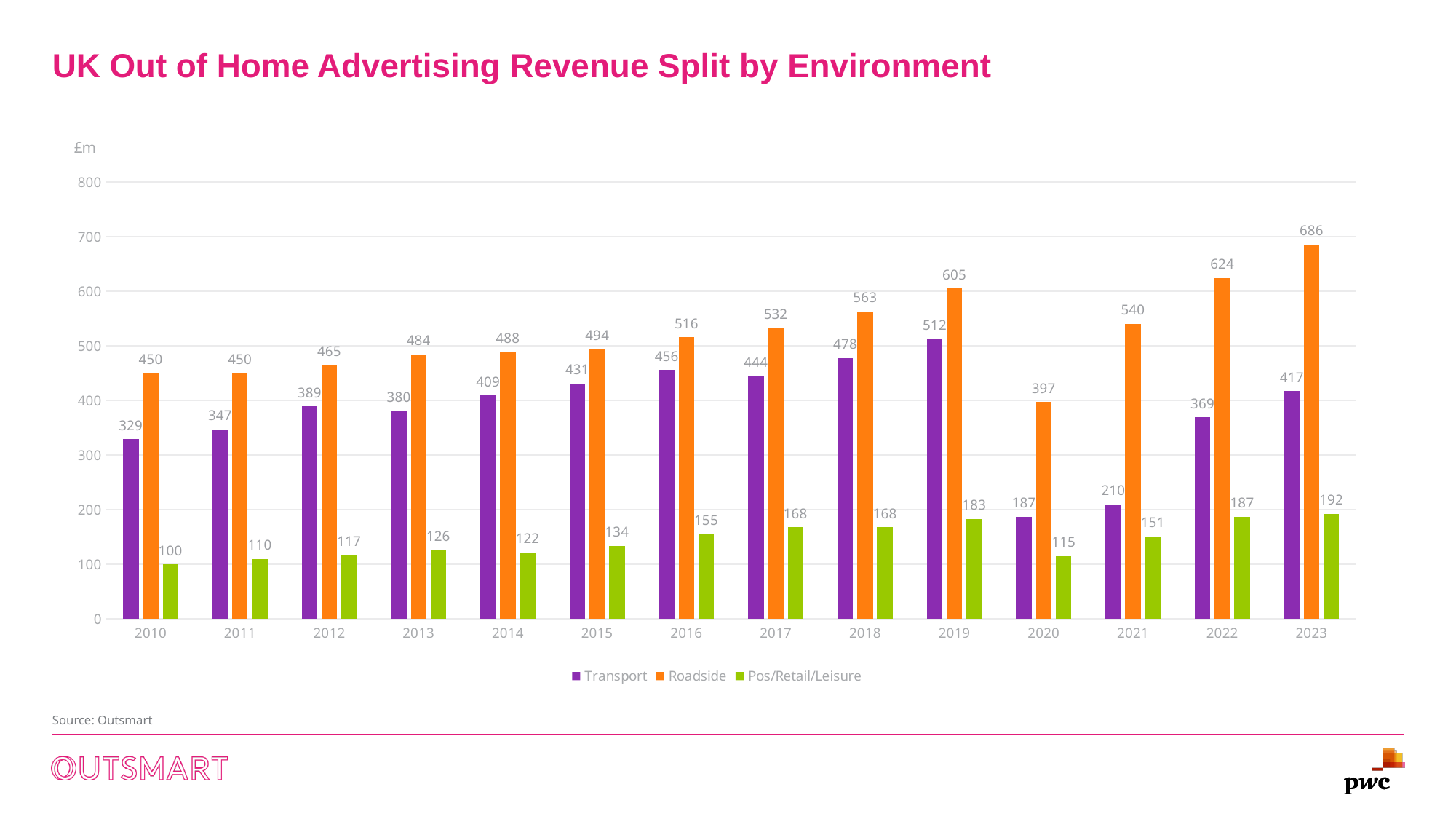
Does the Roadside revenue rise or fall from 2020 to 2023? Rise What is the Pos/Retail/Leisure revenue in 2010? 100 What unit is shown on the y axis? £m How many series does the legend list? 3 In which year is the Transport revenue lowest? 2020 What kind of chart is shown on the slide? Bar chart What is the difference between Roadside and Transport revenue in 2023? 269 What is the Transport revenue in 2019? 512 How many years are shown on the x axis? 14 What is the Roadside revenue in 2023? 686 In which year is the Roadside revenue highest? 2023 Which is larger in 2021: Transport or Pos/Retail/Leisure revenue? Transport